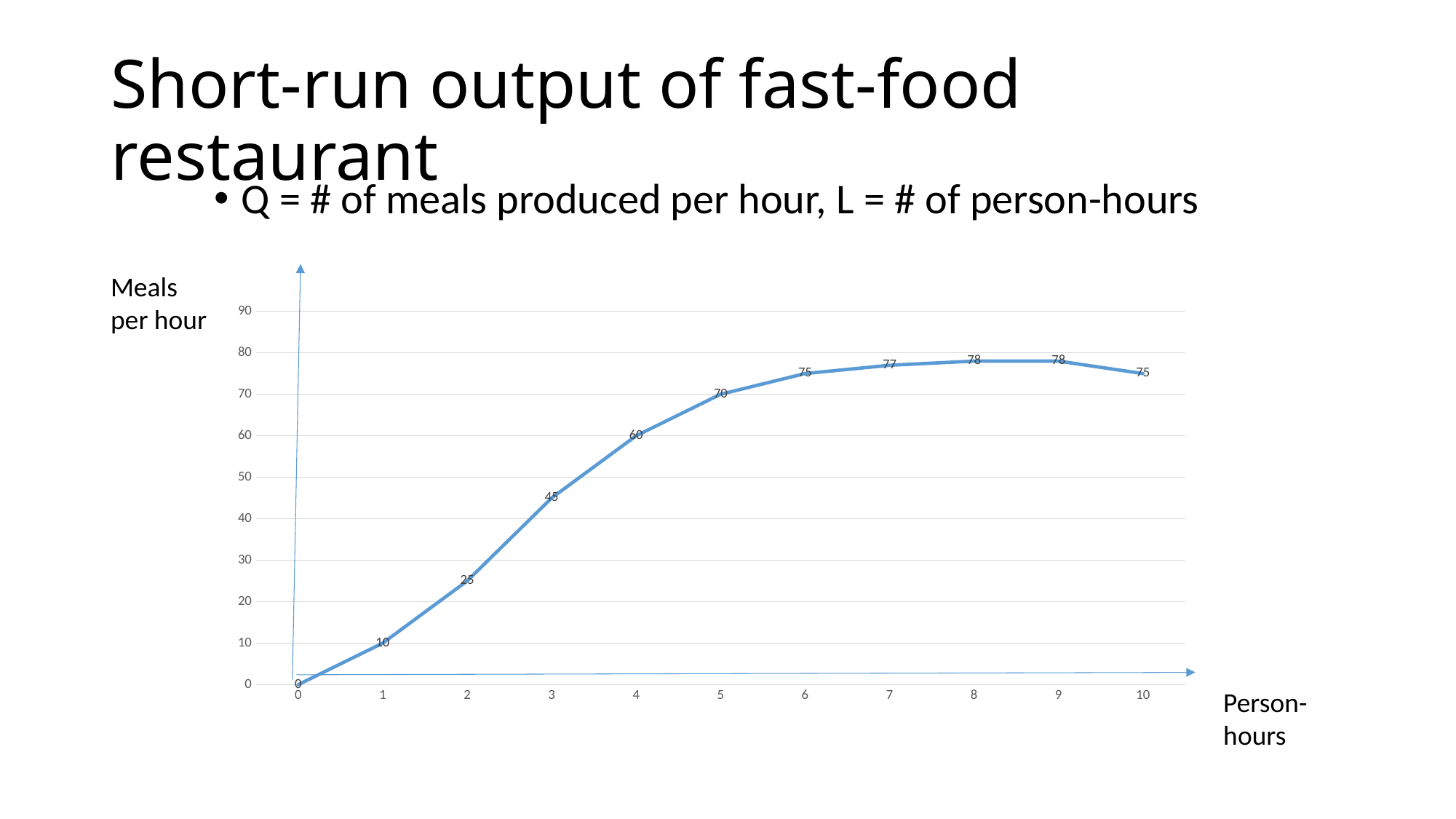
What is the difference between the values at 4 and 2 person-hours? 35 What is the value plotted at 1 person-hour? 10 What is the value plotted at 5 person-hours? 70 How many data points are plotted on the line? 11 What label is shown on the vertical axis of the chart? Meals per hour What is the highest value plotted on the line? 78 Does the line rise or fall between 0 and 8 person-hours? rise At which person-hours value is the lowest output plotted? 0 What is the value plotted at 10 person-hours? 75 Which is larger, the value at 6 person-hours or the value at 10 person-hours? 6 person-hours What type of chart is shown on the slide? line chart How many meals per hour are produced at 3 person-hours? 45